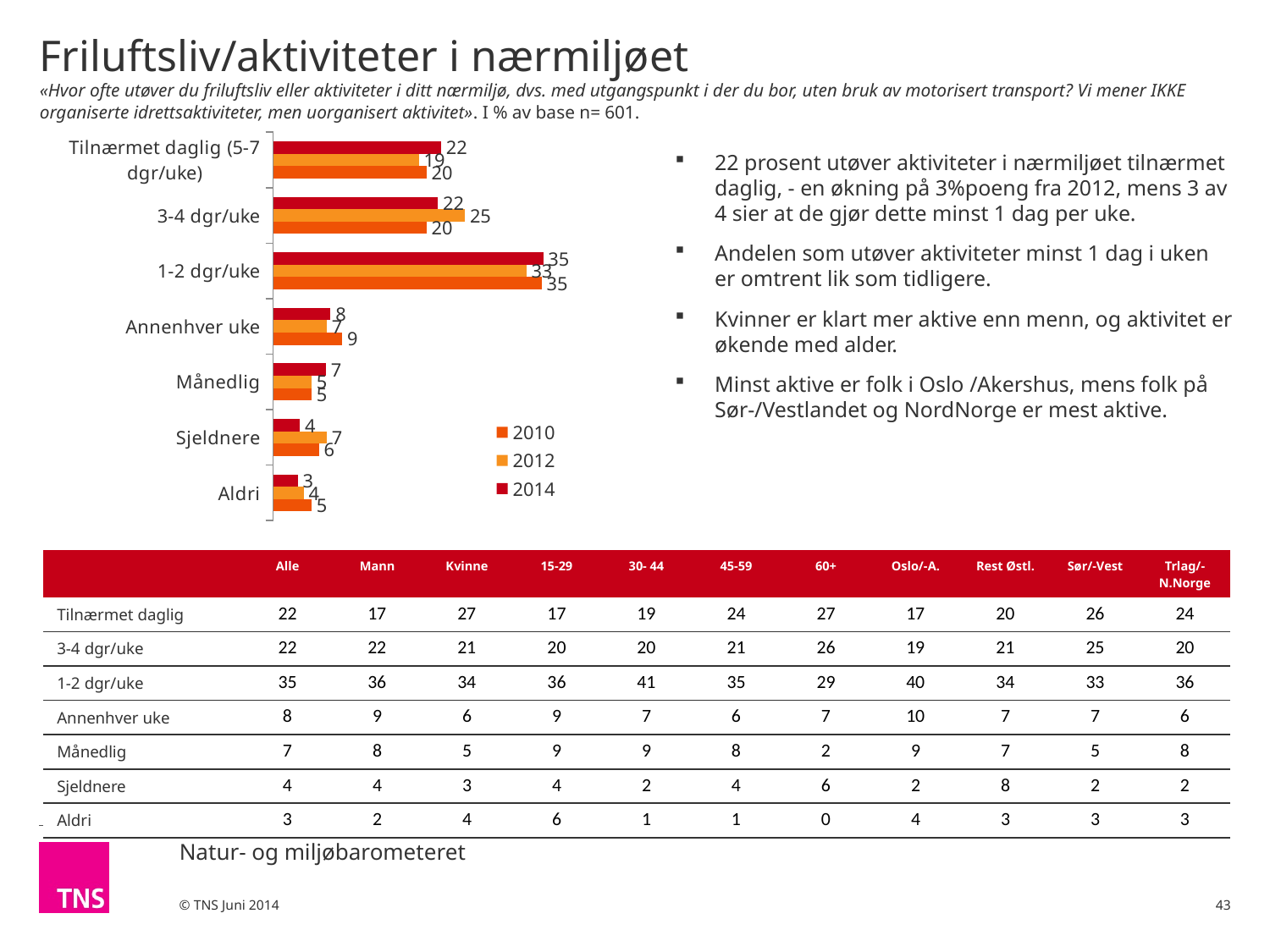
How many categories are shown on the chart? 7 Which category has the highest 2014 value? 1-2 dgr/uke How many series does the chart legend list? 3 What is the 2010 value for 'Annenhver uke'? 9 What is the difference between the 2014 and 2012 values for 'Tilnærmet daglig (5-7 dgr/uke)'? 3 For 'Månedlig', which is larger: the 2014 value or the 2010 value? 2014 What is the 2014 value for '1-2 dgr/uke'? 35 What is the 2012 value for '3-4 dgr/uke'? 25 Which years are listed in the chart legend? 2010, 2012, 2014 What type of chart is shown on the slide? bar chart Which category has the lowest 2014 value? Aldri For 'Sjeldnere', which is larger: the 2012 value or the 2014 value? 2012